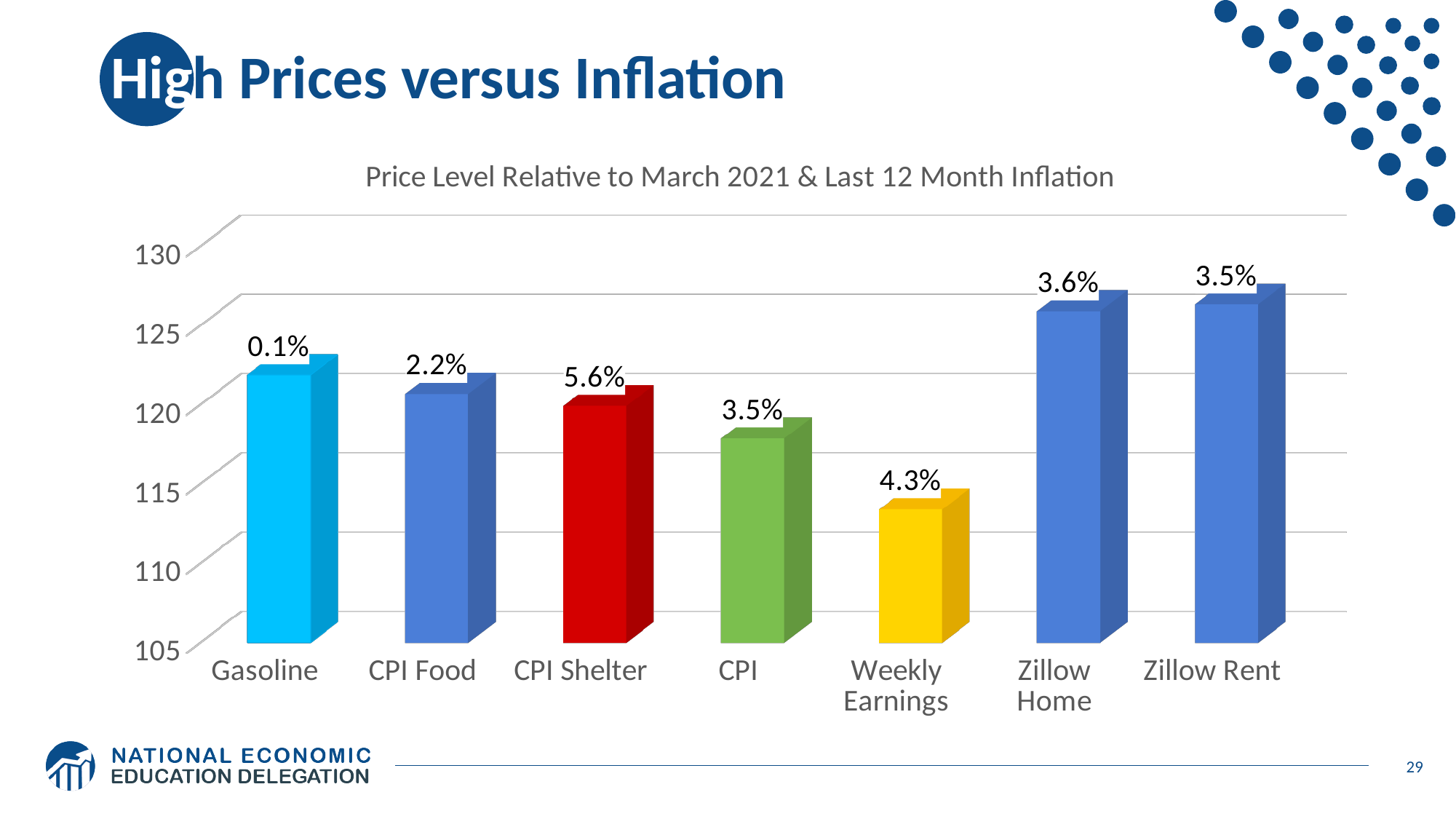
What percentage label is shown above the Weekly Earnings bar? 4.3% What percentage label is shown above the Gasoline bar? 0.1% How many categories are shown on the x axis? 7 Is the bar for Zillow Home greater or less than 125? greater Which category has the shortest bar (lowest price level)? Weekly Earnings What percentage label is shown above the CPI Shelter bar? 5.6% Which category has the lowest percentage label printed above its bar? Gasoline What is the difference between the percentage labels for CPI Shelter and CPI? 2.1 percentage points Is the bar for Weekly Earnings greater or less than 115? less Which bar is taller, Gasoline or CPI Food? Gasoline What percentage label is shown above the Zillow Home bar? 3.6% Which category has the highest percentage label printed above its bar? CPI Shelter